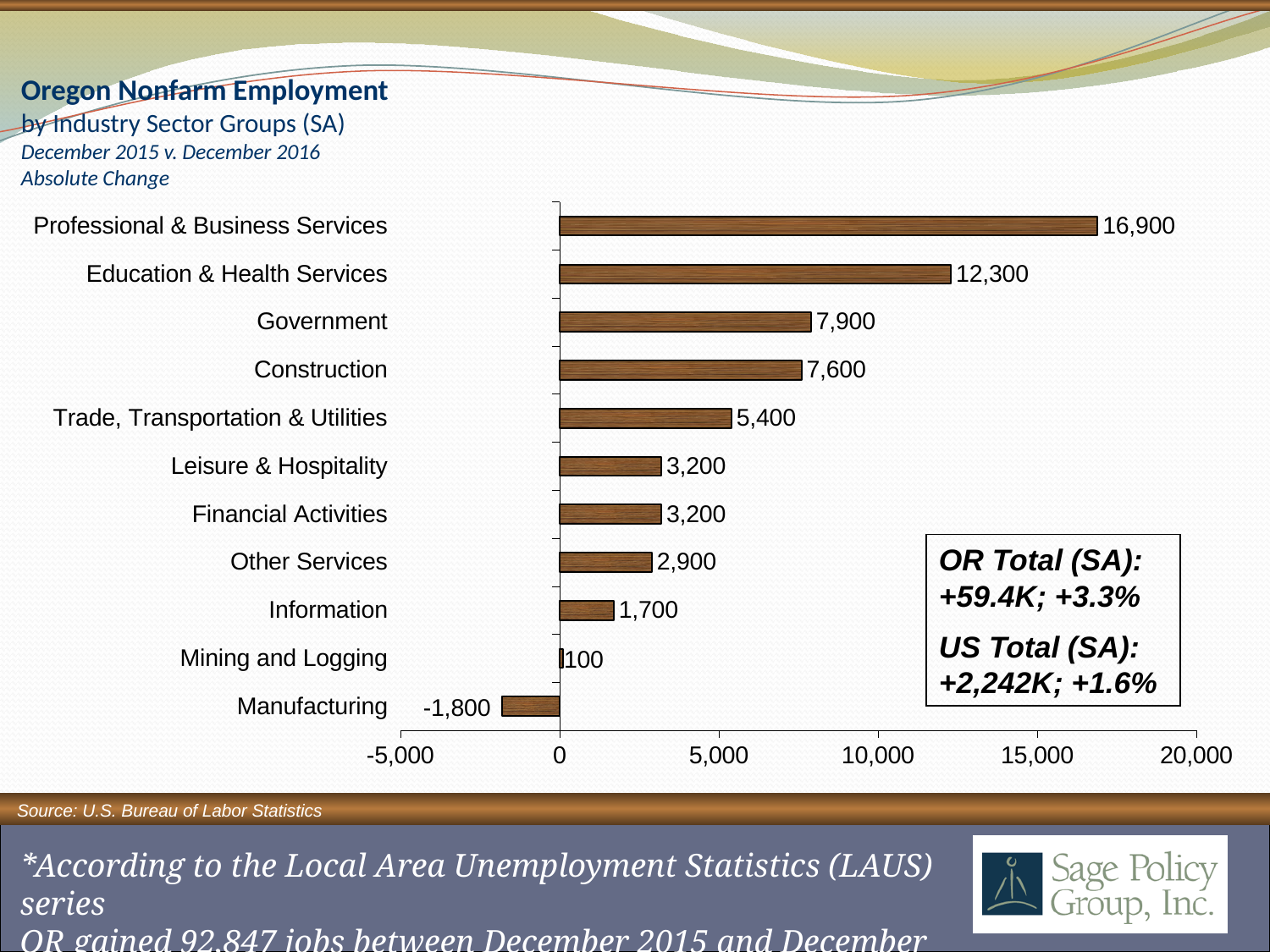
What is the absolute change in employment for Professional & Business Services? 16,900 What is the absolute change in employment for Mining and Logging? 100 What kind of chart is shown on the slide? Bar chart What is the difference between the absolute change for Education & Health Services and Government? 4,400 What is the absolute change in employment for Government? 7,900 How many industry sector groups are shown in the chart? 11 Which industry sector group has the lowest absolute change? Manufacturing Which industry sector group has the highest absolute change? Professional & Business Services Which has a larger absolute change, Construction or Trade, Transportation & Utilities? Construction Is the value for Education & Health Services greater or less than 10,000? greater What is the OR Total (SA) change shown in the text box on the chart? +59.4K; +3.3% What is the absolute change in employment for Manufacturing? -1,800